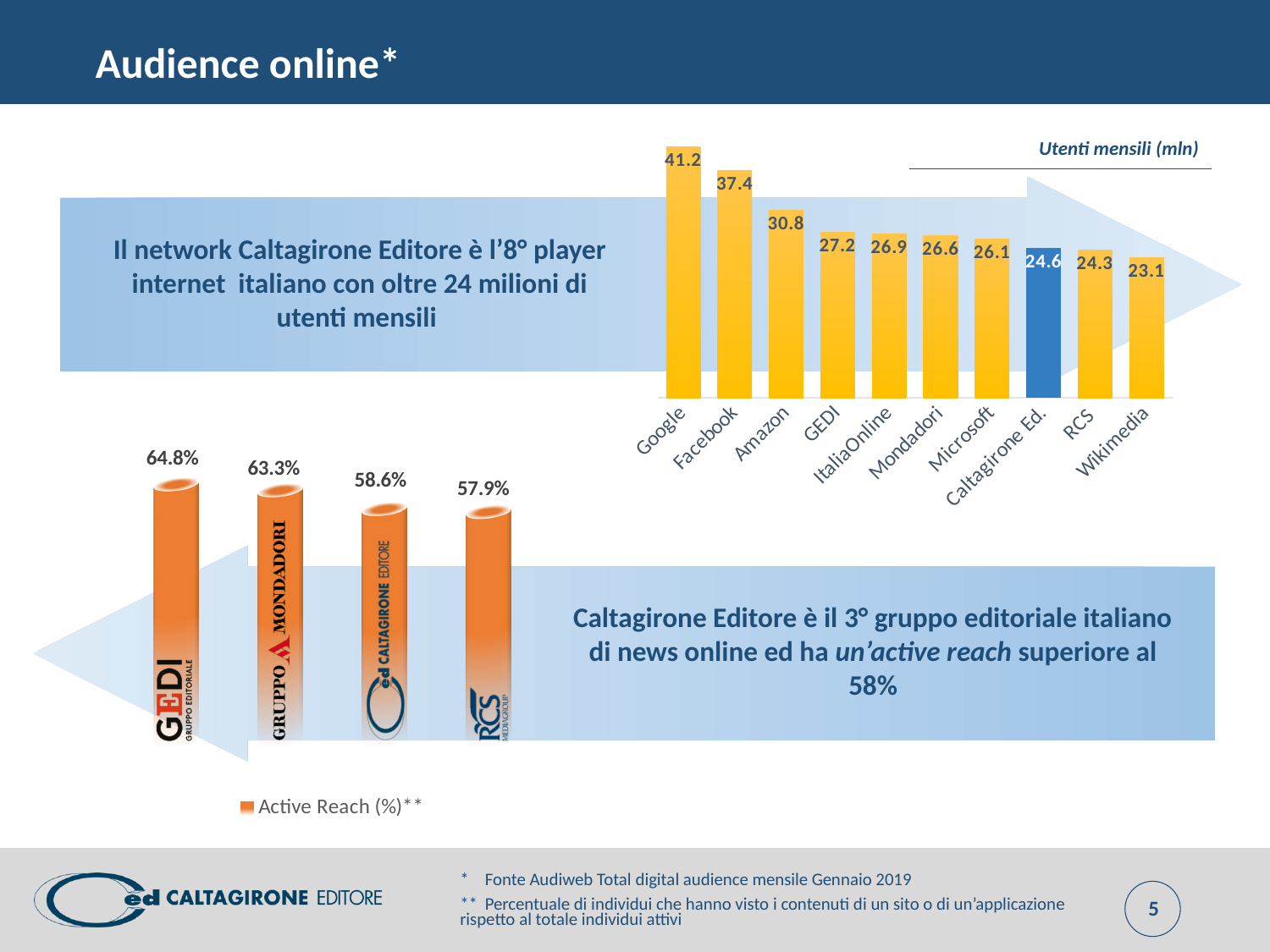
In the 'Utenti mensili (mln)' chart, which category has the highest value? Google In the 'Utenti mensili (mln)' chart, what is the difference between Google and Facebook? 3.8 In the 'Active Reach (%)' chart at the bottom left, which is larger: Mondadori or RCS? Mondadori What kind of chart is the 'Active Reach (%)' chart at the bottom left? bar chart In the 'Utenti mensili (mln)' chart, do the values rise or fall from left to right? fall In the 'Utenti mensili (mln)' chart, what is the value for Google? 41.2 In the 'Active Reach (%)' chart at the bottom left, what is the value for GEDI? 64.8% In the 'Utenti mensili (mln)' chart, how many categories are shown? 10 In the 'Utenti mensili (mln)' chart, what is the value for Caltagirone Ed.? 24.6 In the 'Active Reach (%)' chart at the bottom left, what is the value for Caltagirone Editore? 58.6% In the 'Utenti mensili (mln)' chart, which category has the lowest value? Wikimedia In the 'Utenti mensili (mln)' chart, which bar is coloured blue instead of yellow? Caltagirone Ed.